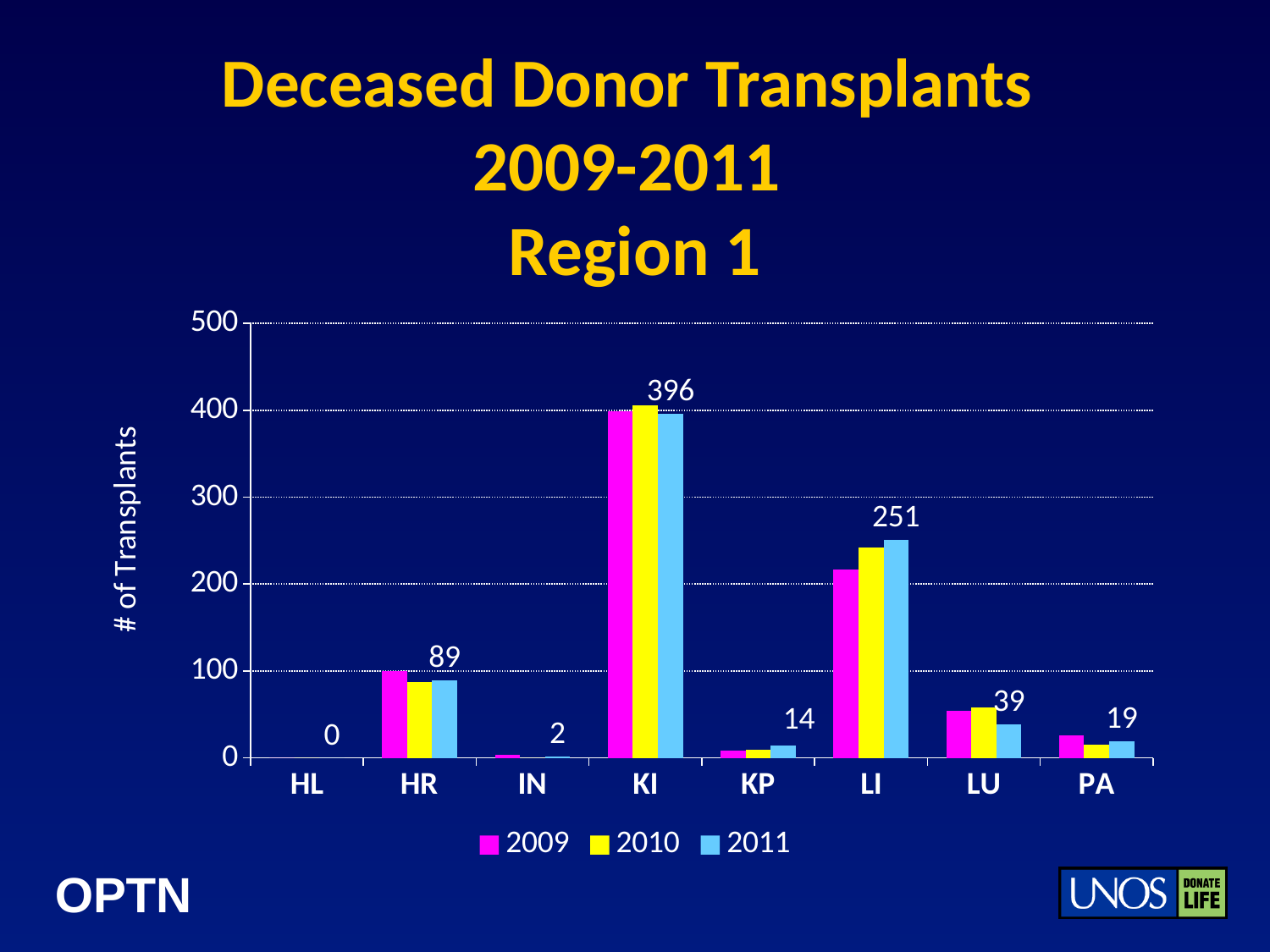
What is the value for HR in 2011? 89 What kind of chart is shown on the slide? bar chart Is the value for KI in 2009 greater or less than 300? greater What is the value for LI in 2011? 251 Which is larger in 2011, LU or PA? LU How many categories are shown on the x axis? 8 Which category has the lowest value in 2011? HL How many series does the legend list? 3 Which category has the highest value in 2011? KI What is the value for KI in 2011? 396 What is the value for HL in 2011? 0 What is the difference between the 2011 values for KI and LI? 145